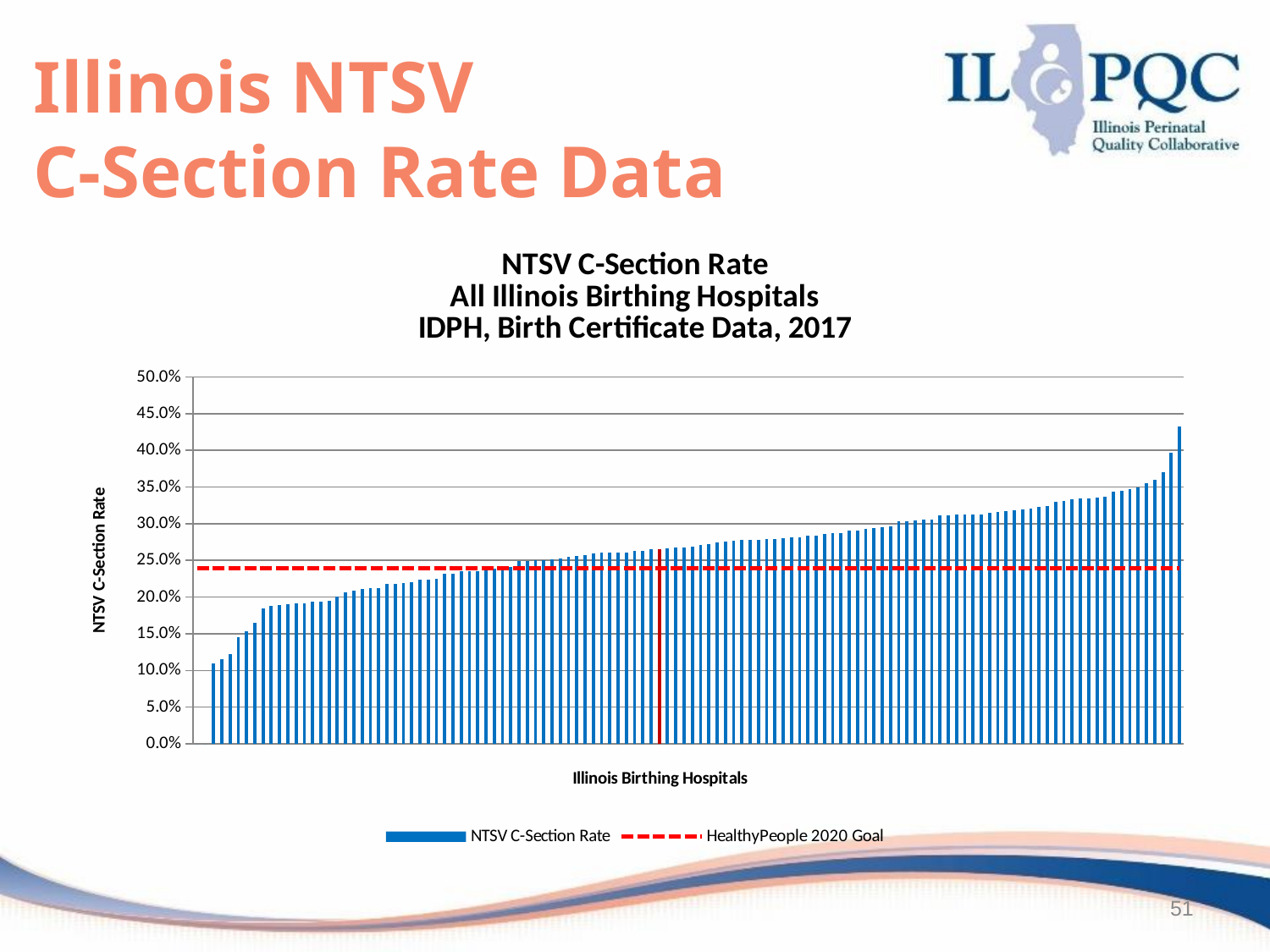
How many series does the legend list? 2 Is the HealthyPeople 2020 Goal line greater or less than 25.0%? less Is the value of the shortest NTSV C-Section Rate bar greater or less than 15.0%? less Is the HealthyPeople 2020 Goal line greater or less than 20.0%? greater What are the two entries listed in the chart legend? NTSV C-Section Rate and HealthyPeople 2020 Goal What kind of chart is shown on the slide? bar chart Do the NTSV C-Section Rate bars rise or fall from left to right along the x axis? rise What is the title of the x axis of the chart? Illinois Birthing Hospitals